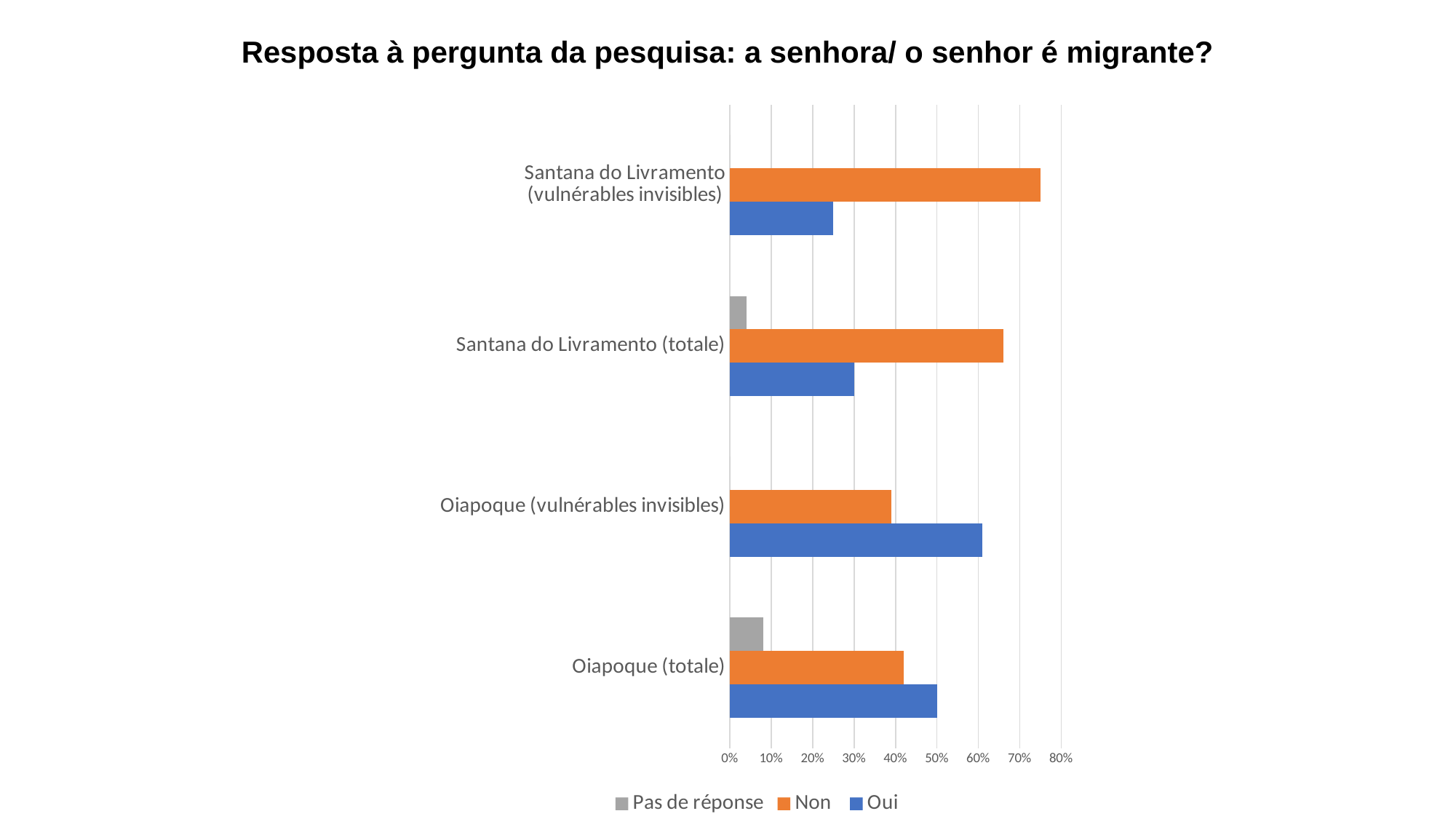
For Santana do Livramento (totale), which is larger, Oui or Non? Non For Oiapoque (vulnérables invisibles), which is larger, Oui or Non? Oui Is the Non value for Santana do Livramento (vulnérables invisibles) greater or less than 70%? greater Which category has the highest value for the Non series? Santana do Livramento (vulnérables invisibles) How many categories are shown on the vertical axis? 4 Which category has the highest value for the Oui series? Oiapoque (vulnérables invisibles) Which colour represents the Non series in the legend? orange Is the Pas de réponse value for Oiapoque (totale) greater or less than 10%? less How many series does the legend list? 3 Which category has the lowest value for the Oui series? Santana do Livramento (vulnérables invisibles) What kind of chart is shown on the slide? bar chart